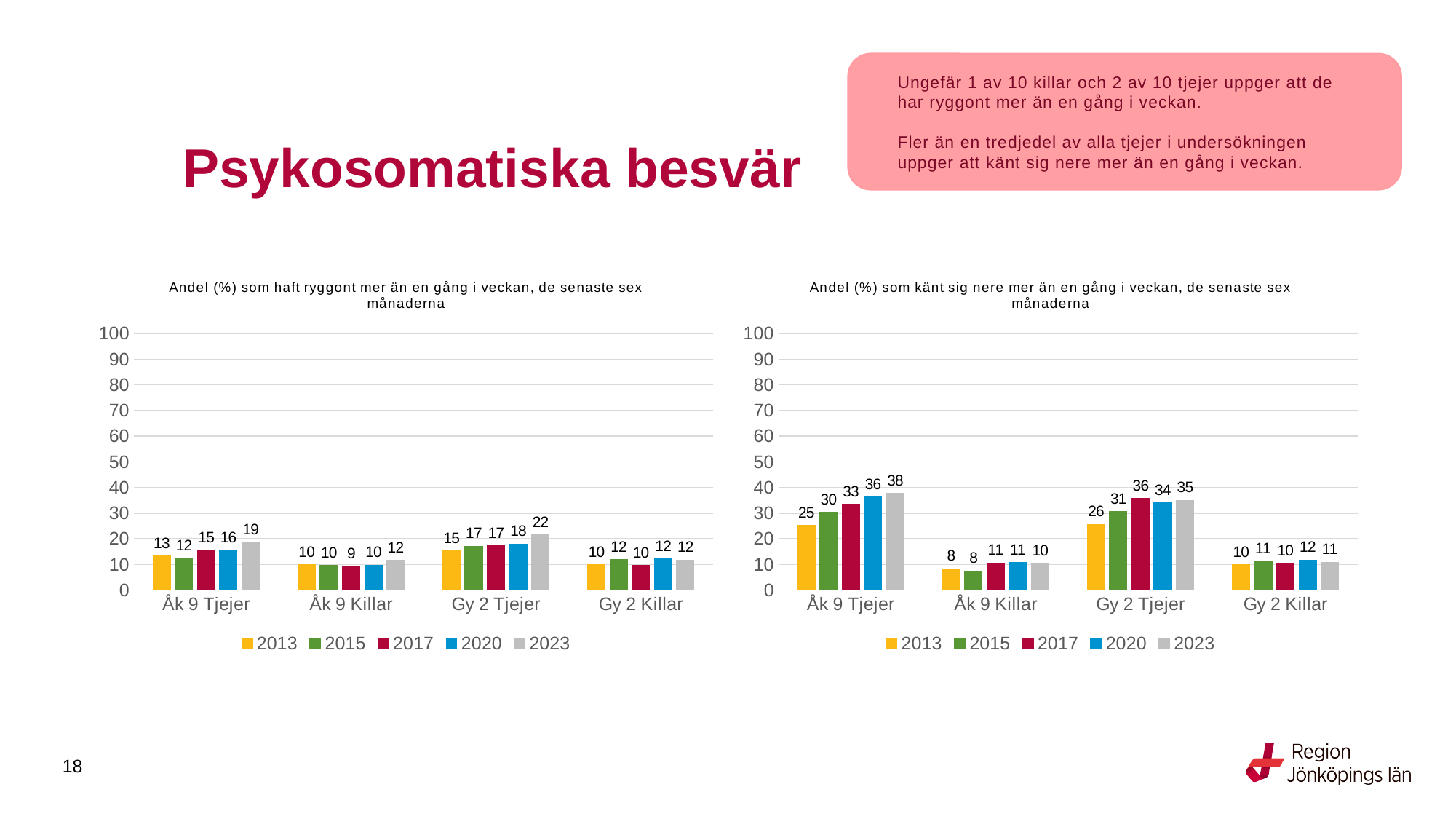
In the right chart (känt sig nere), what is the value for Åk 9 Tjejer in 2020? 36 What kind of chart is the left chart (ryggont)? Bar chart In the right chart (känt sig nere), which is larger for Gy 2 Tjejer: the 2017 value or the 2020 value? 2017 How many categories are shown on the x axis of the left chart (ryggont)? 4 In the right chart (känt sig nere), which category has the highest value in 2023? Åk 9 Tjejer In the right chart (känt sig nere), is the value for Gy 2 Tjejer in 2013 greater or less than 20? greater In the left chart (ryggont), what is the value for Gy 2 Tjejer in 2023? 22 In the left chart (ryggont), what is the difference between Gy 2 Tjejer and Gy 2 Killar in 2020? 6 How many series does the legend of the right chart (känt sig nere) list? 5 In the right chart (känt sig nere), do the values for Åk 9 Tjejer rise or fall from 2013 to 2023? Rise In the right chart (känt sig nere), what is the difference between the 2023 and 2013 values for Åk 9 Tjejer? 13 In the left chart (ryggont), which category has the lowest value in 2017? Åk 9 Killar